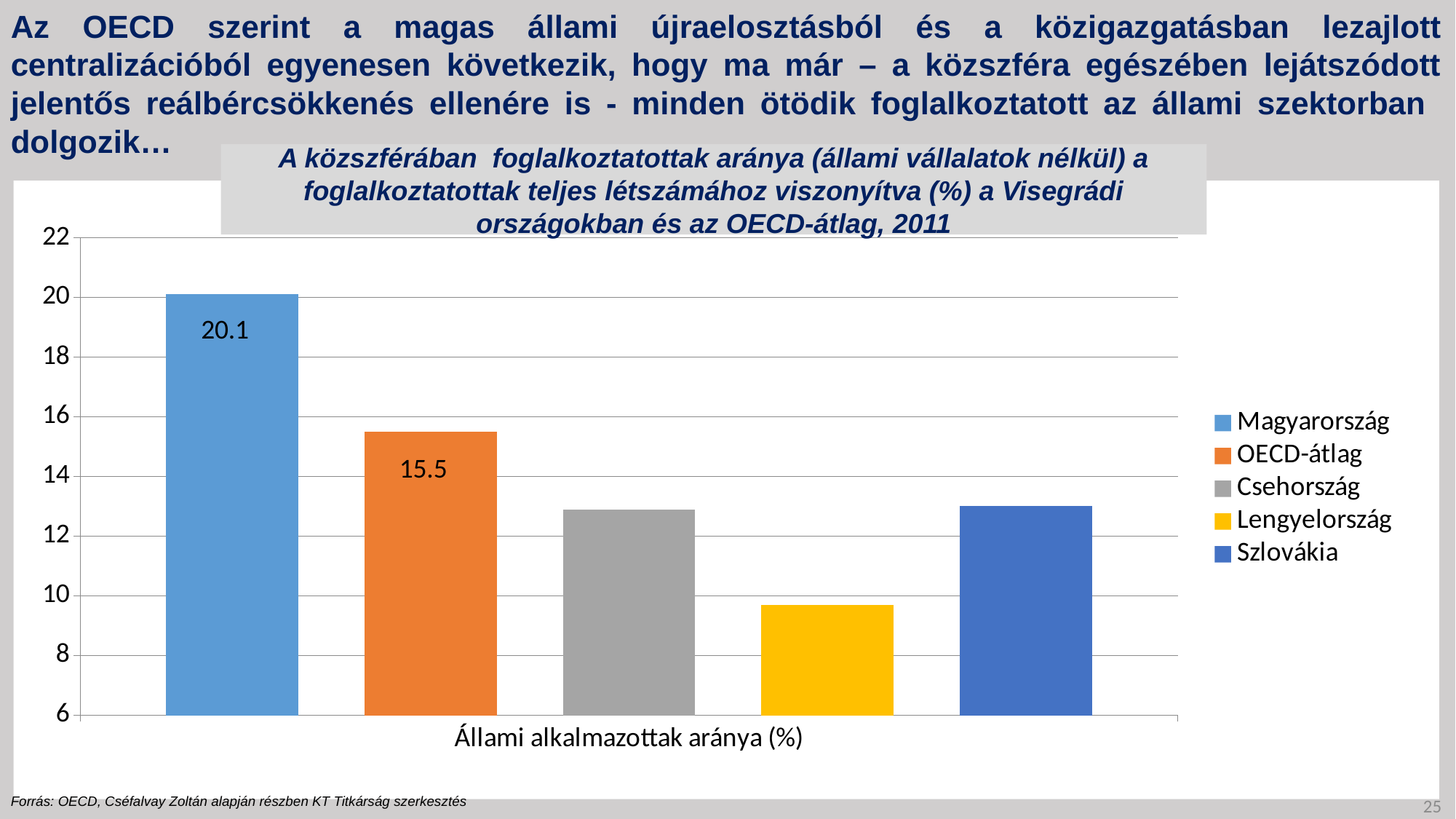
What kind of chart is shown on the slide? bar chart Which is larger, the value for Magyarország or the value for OECD-átlag? Magyarország Which series has the lowest value? Lengyelország Is the value for Szlovákia greater or less than 12? greater Which series has the highest value? Magyarország What is the difference between the values for Magyarország and OECD-átlag? 4.6 Is the value for Csehország greater or less than 14? less How many series does the legend list? 5 What is the value for OECD-átlag? 15.5 Is the value for Lengyelország greater or less than 10? less What is the value for Magyarország? 20.1 What is the label shown under the bars on the x axis? Állami alkalmazottak aránya (%)